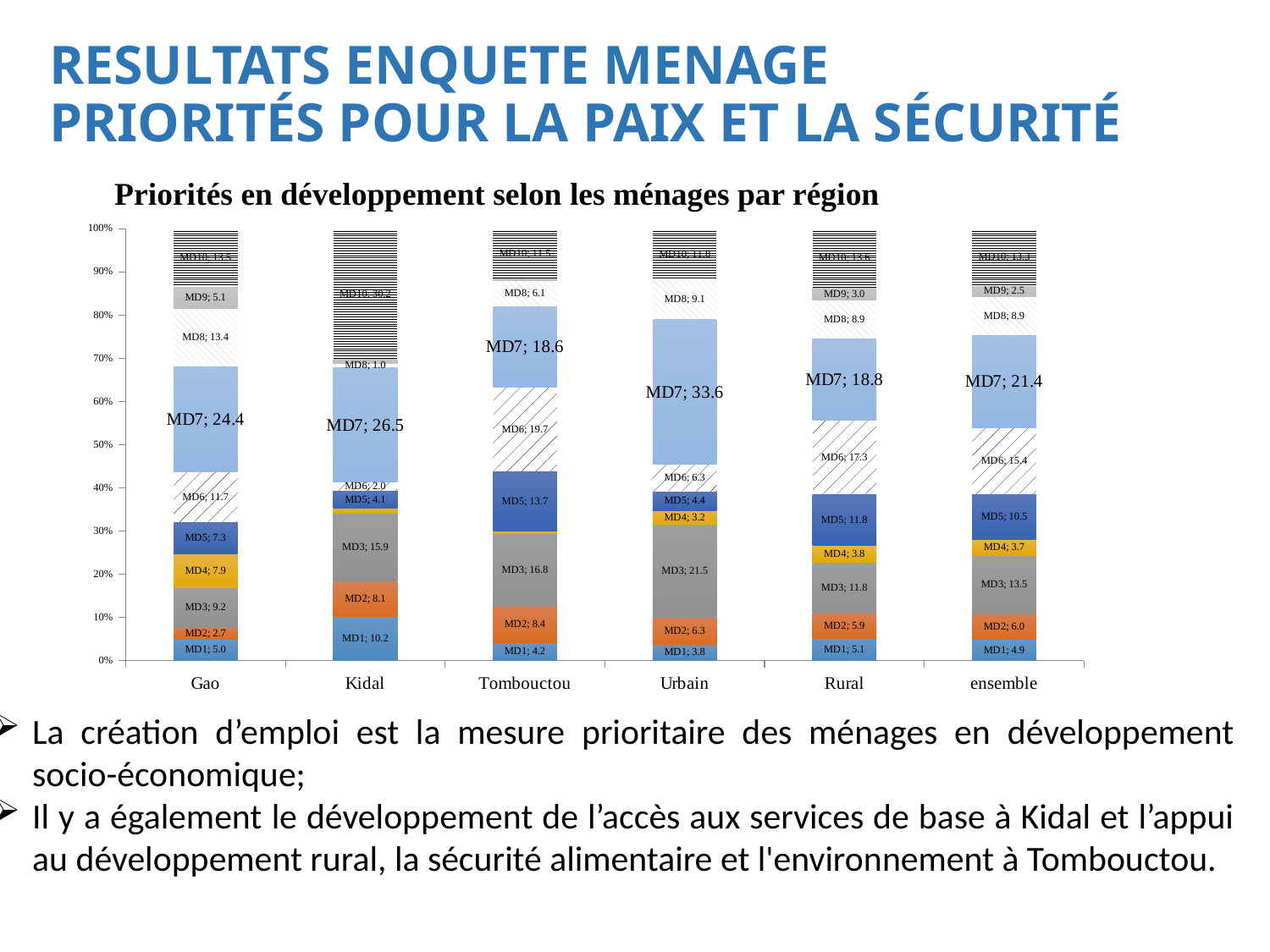
Which is larger, the MD2 value for Kidal or the MD2 value for Gao? Kidal How many regions/categories are shown along the x axis of the chart? 6 What is the value of MD1 for Kidal? 10.2 Which category has the highest value for MD1? Kidal What kind of chart is shown on the slide? Stacked bar chart What is the value of MD3 for Urbain? 21.5 What is the value of MD5 for Rural? 11.8 What is the value of MD7 for Urbain? 33.6 What is the difference between the MD7 value for Urbain and the MD7 value for Gao? 9.2 Which category has the highest value for MD7? Urbain What is the title of the chart? Priorités en développement selon les ménages par région What is the value of MD6 for Tombouctou? 19.7